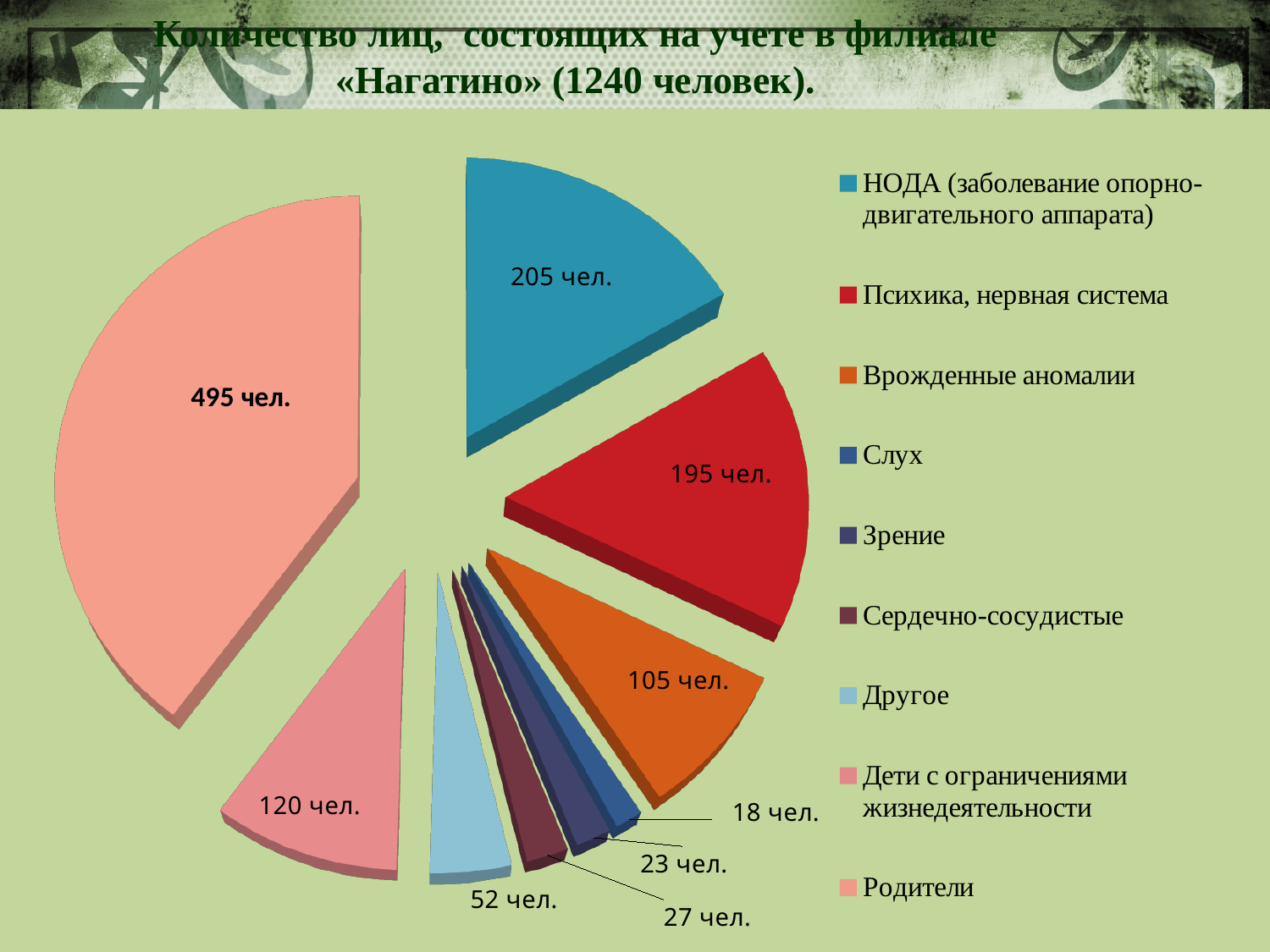
What is the value for Дети с ограничениями жизнедеятельности? 120 чел. Which category has the largest slice of the pie? Родители How many people are in the НОДА (заболевание опорно-двигательного аппарата) category? 205 чел. What kind of chart is shown on the slide? Pie chart Which is larger: Зрение or Сердечно-сосудистые? Сердечно-сосудистые Which category has the smallest slice of the pie? Слух How many categories does the pie chart have? 9 What is the value for the Родители slice? 495 чел. What is the difference between the Родители value and the НОДА value? 290 чел. What is the total number of people shown in the chart title? 1240 человек How many people are in the Слух category? 18 чел. What is the difference between Психика, нервная система and Врожденные аномалии? 90 чел.